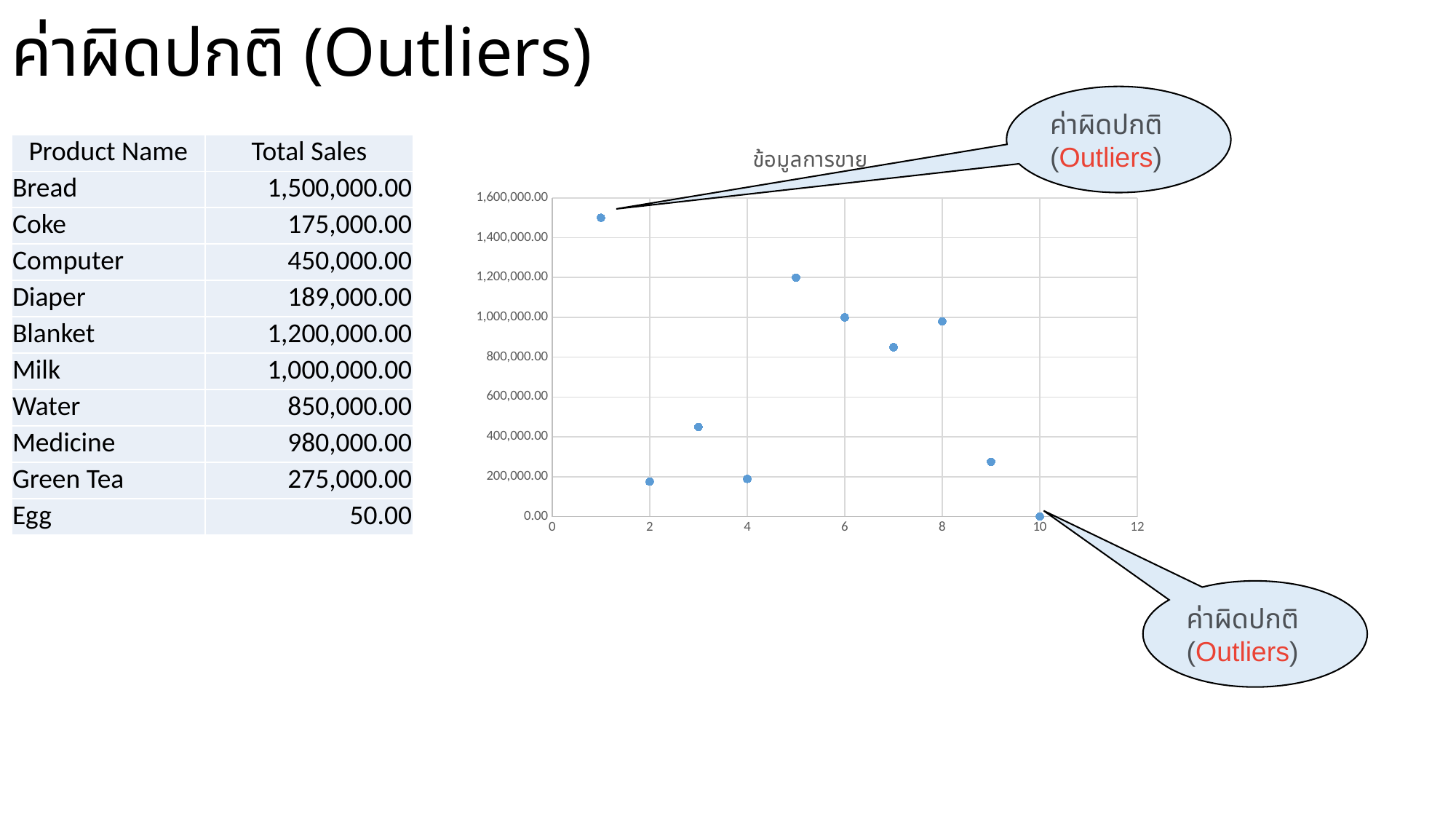
What kind of chart is shown on the slide? scatter chart At which x value does the chart's highest point occur? 1 What is the title of the chart? ข้อมูลการขาย At which x value does the chart's lowest point occur? 10 Is the value of the point at x = 1 greater or less than 1,400,000.00? greater How many data points are plotted in the chart? 10 What is the highest value shown on the chart's y axis? 1,600,000.00 Is the value of the point at x = 2 greater or less than 200,000.00? less Which point has a larger value, the one at x = 7 or the one at x = 8? x = 8 Is the value of the point at x = 5 greater or less than 1,000,000.00? greater Which point has a larger value, the one at x = 3 or the one at x = 9? x = 3 What is the y value of the point at x = 6? 1,000,000.00